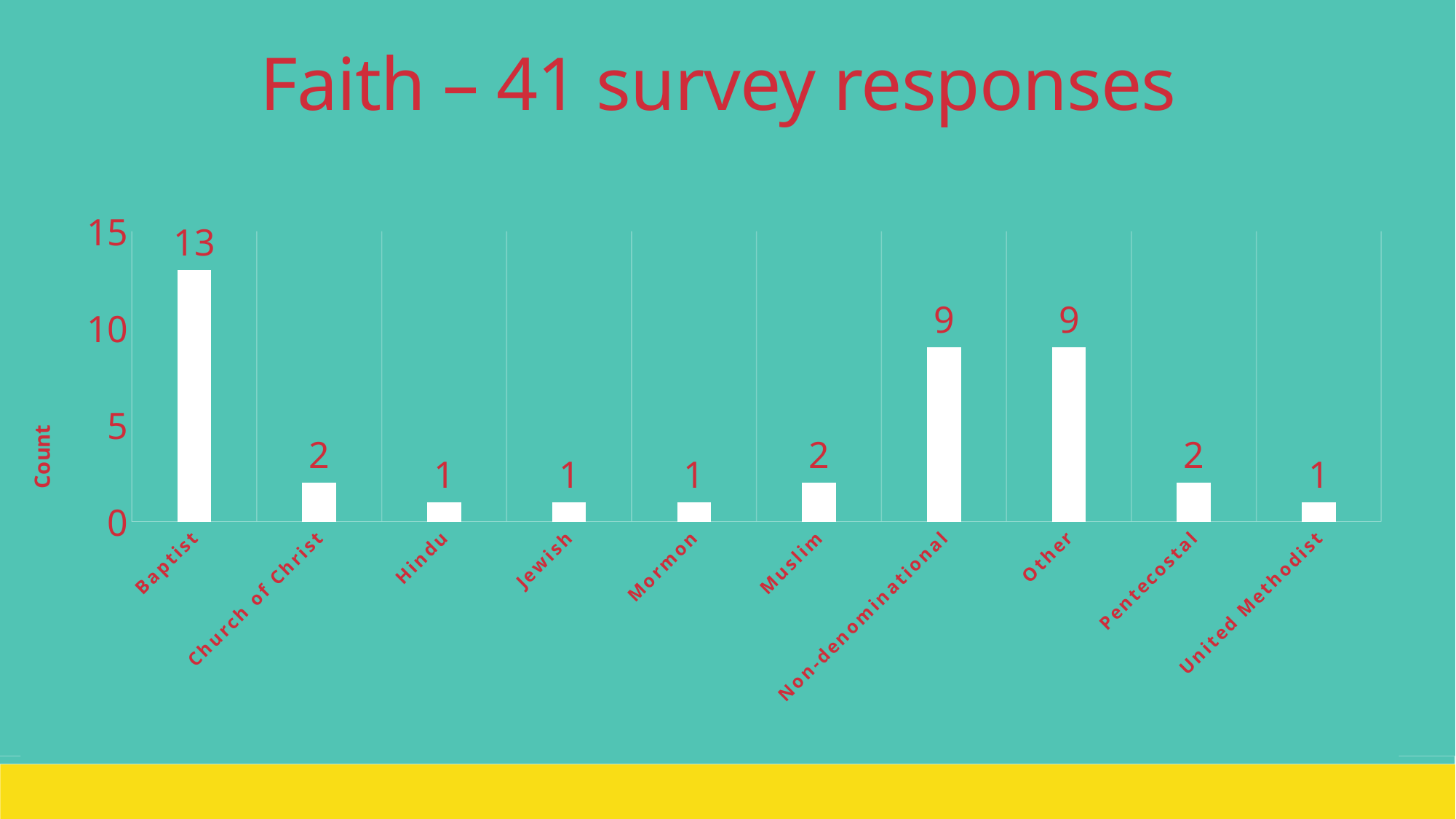
How many faith categories are shown on the x axis? 10 Is the value for Baptist greater or less than 10? greater What is the count for Non-denominational? 9 What is the count for Pentecostal? 2 What is the title of the chart? Faith – 41 survey responses What is the count for Baptist? 13 What is the label on the vertical axis? Count Which has a larger count, Muslim or Non-denominational? Non-denominational Which faith category has the highest count? Baptist What is the count for Mormon? 1 What kind of chart is shown on the slide? bar chart What is the difference between the count for Baptist and the count for Other? 4